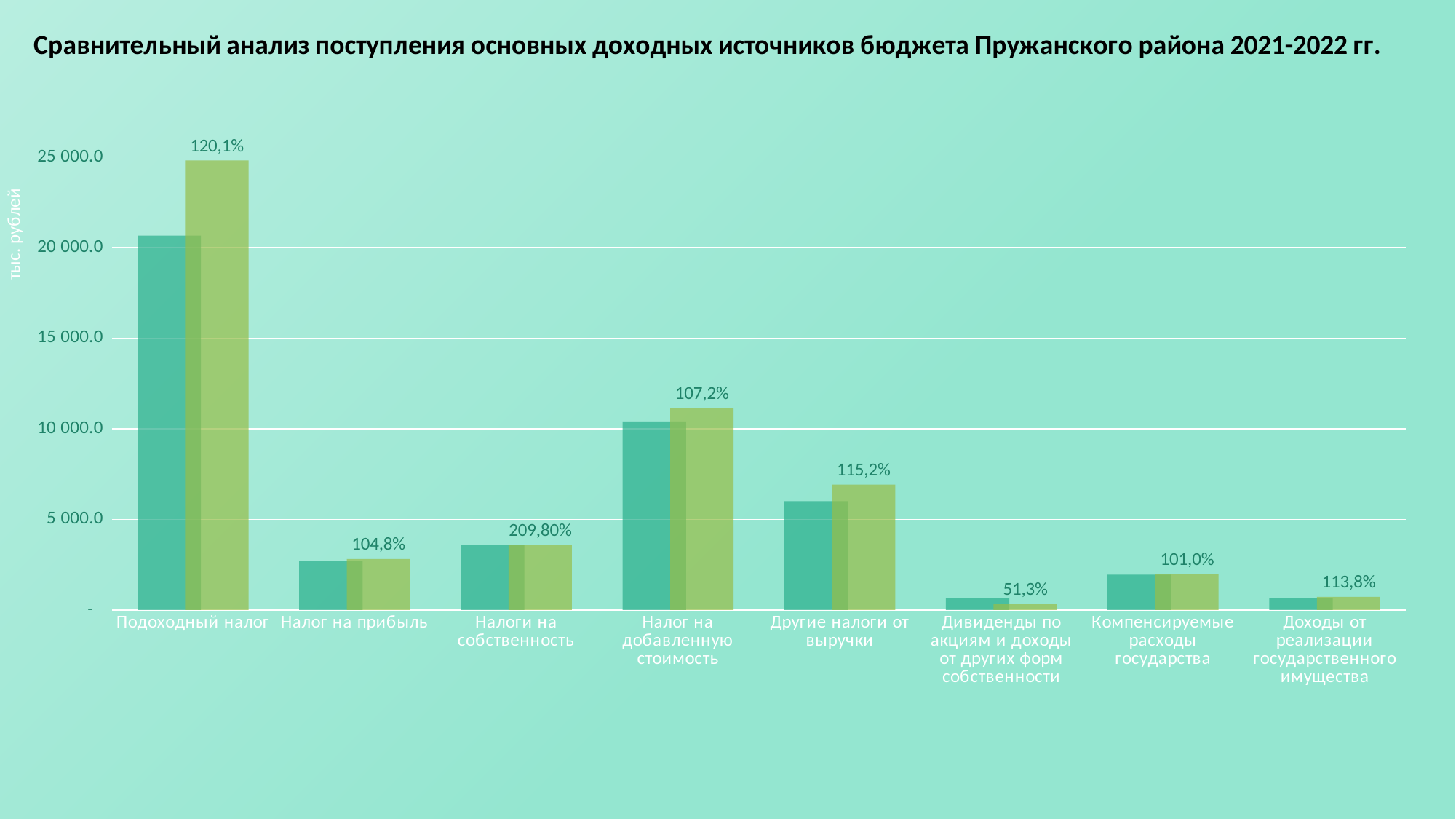
What unit is shown on the vertical axis label? тыс. рублей What is the title of the chart? Сравнительный анализ поступления основных доходных источников бюджета Пружанского района 2021-2022 гг. Which category has taller bars: Налог на добавленную стоимость or Другие налоги от выручки? Налог на добавленную стоимость Which category has the highest percentage label? Налоги на собственность What percentage label is shown for Подоходный налог? 120,1% What percentage label is shown for Налоги на собственность? 209,80% What kind of chart is shown on the slide? bar chart Which category has the tallest bars? Подоходный налог How many categories are shown on the x axis? 8 What percentage label is shown for Дивиденды по акциям и доходы от других форм собственности? 51,3% Is the value of the taller bar for Подоходный налог greater or less than 20 000.0? greater Which category has the lowest percentage label? Дивиденды по акциям и доходы от других форм собственности